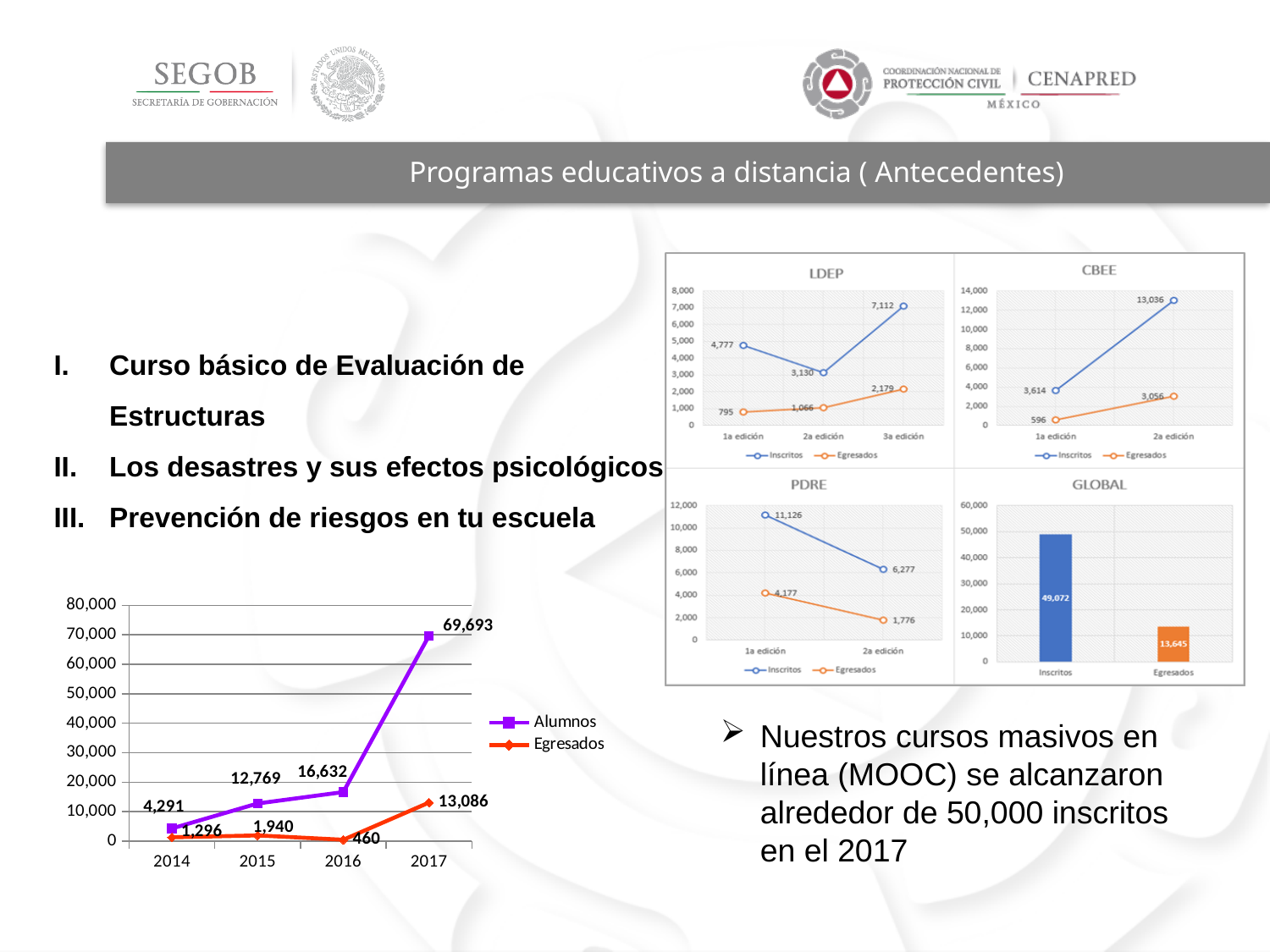
In the bottom-left line chart, what is the difference between Alumnos and Egresados in 2017? 56,607 What kind of chart is the GLOBAL chart? bar chart In the bottom-left line chart, which year has the highest value for Alumnos? 2017 In the bottom-left line chart, how many series does the legend list? 2 In the PDRE chart, which is larger: Inscritos in the 1a edición or Inscritos in the 2a edición? 1a edición In the bottom-left line chart, how many years are shown on the x axis? 4 In the bottom-left line chart, what is the value for Alumnos in 2017? 69,693 In the bottom-left line chart, do the Alumnos values rise or fall from 2014 to 2017? rise In the bottom-left line chart, which year has the lowest value for Egresados? 2016 In the bottom-left line chart, what is the value for Egresados in 2016? 460 In the GLOBAL chart, what is the value for Inscritos? 49,072 In the CBEE chart, what is the value for Inscritos in the 2a edición? 13,036